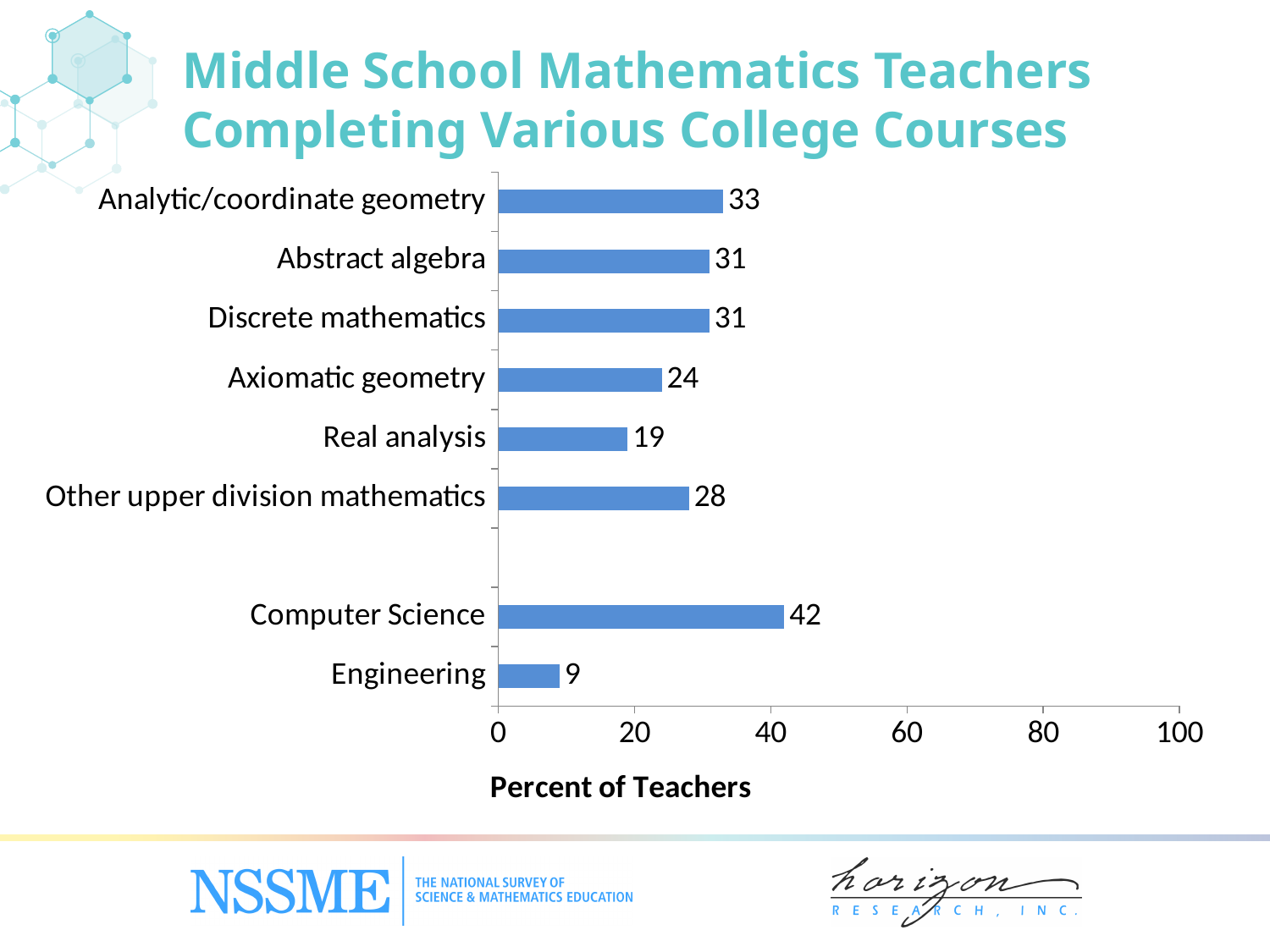
Which course has the lowest percent of teachers? Engineering What is the value for Other upper division mathematics? 28 Which course has the highest percent of teachers? Computer Science What is the value for Real analysis? 19 What is the difference between Analytic/coordinate geometry and Axiomatic geometry? 9 How many courses are shown in the chart? 8 What is the difference between the values for Computer Science and Engineering? 33 What kind of chart is shown on the slide? bar chart What is the label of the horizontal axis? Percent of Teachers What percent of teachers completed Computer Science? 42 Is the value for Computer Science greater or less than 40? greater Which is larger, the value for Axiomatic geometry or Other upper division mathematics? Other upper division mathematics